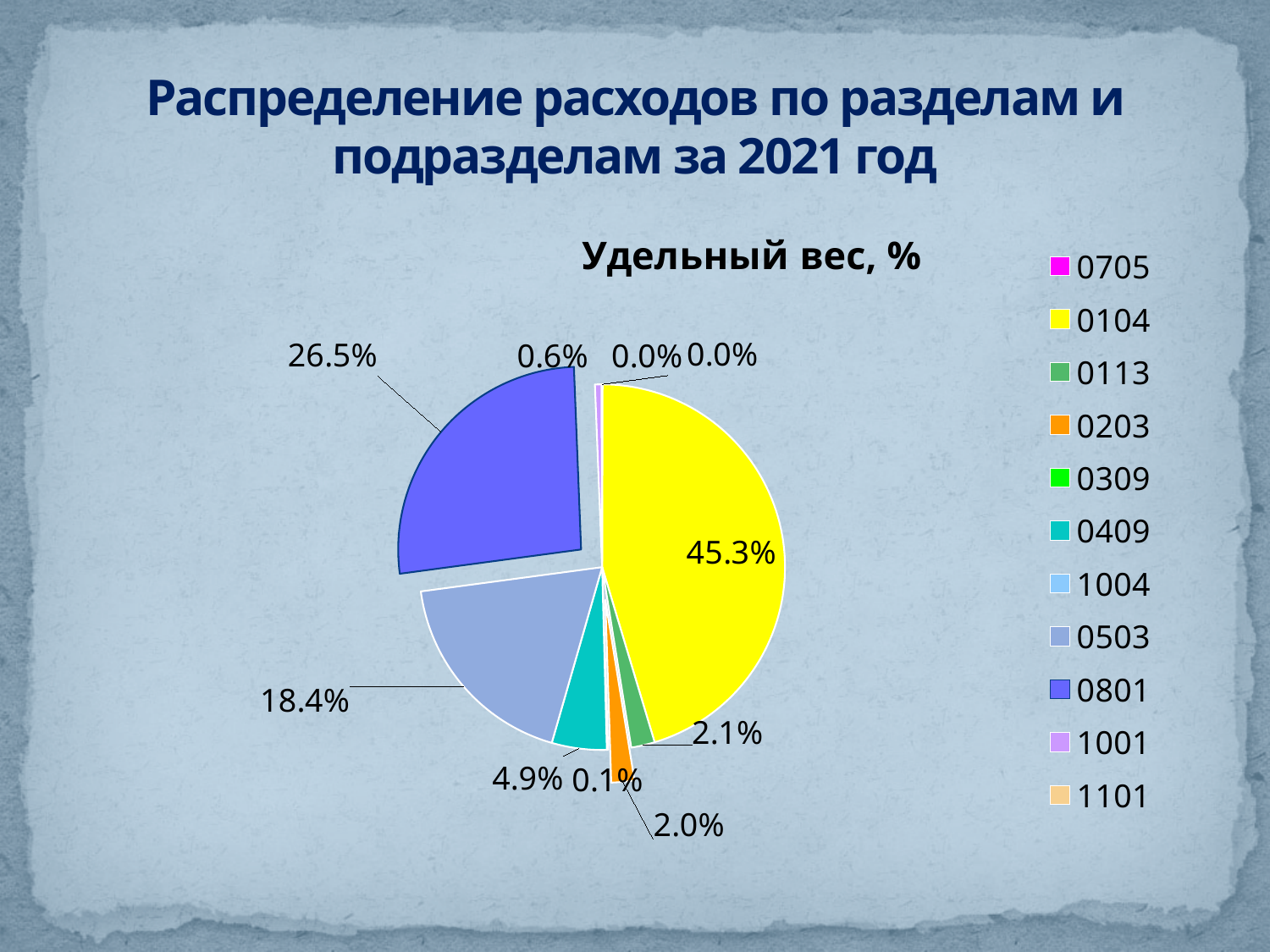
What is the share for category 0503? 18.4% What is the share for category 0801? 26.5% What is the title of the chart? Удельный вес, % How many categories does the chart legend list? 11 What type of chart is shown on the slide? pie chart What is the share for category 0104? 45.3% Which category has the largest share of the pie? 0104 What is the share for category 0203? 2.0% What is the share for category 1001? 0.6% What is the difference between the shares of 0104 and 0801? 18.8% Which category has the larger share, 0801 or 0503? 0801 What is the share for category 0409? 4.9%